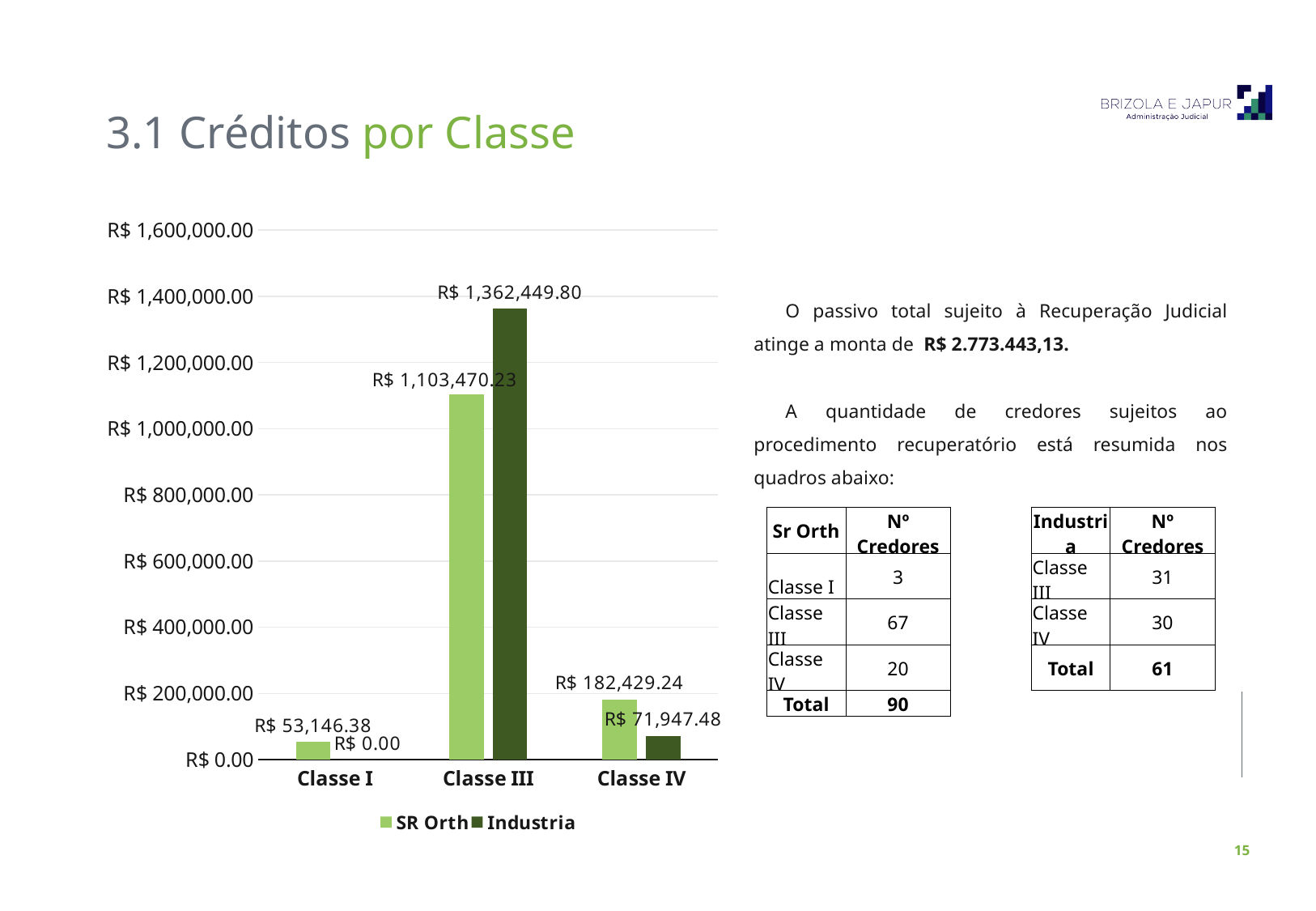
What is the SR Orth value for Classe III? R$ 1,103,470.23 What type of chart is shown on the slide? bar chart How many series does the chart legend list? 2 How many classes (categories) are shown on the x axis of the chart? 3 For Classe IV, which series has the larger value, SR Orth or Industria? SR Orth Which class has the highest Industria value? Classe III What is the Industria value for Classe III? R$ 1,362,449.80 What is the SR Orth value for Classe I? R$ 53,146.38 What is the Industria value for Classe IV? R$ 71,947.48 Which series is shown in the darker green colour in the chart? Industria Which class has the lowest SR Orth value? Classe I What is the difference between the Industria and SR Orth values for Classe III? R$ 258,979.57